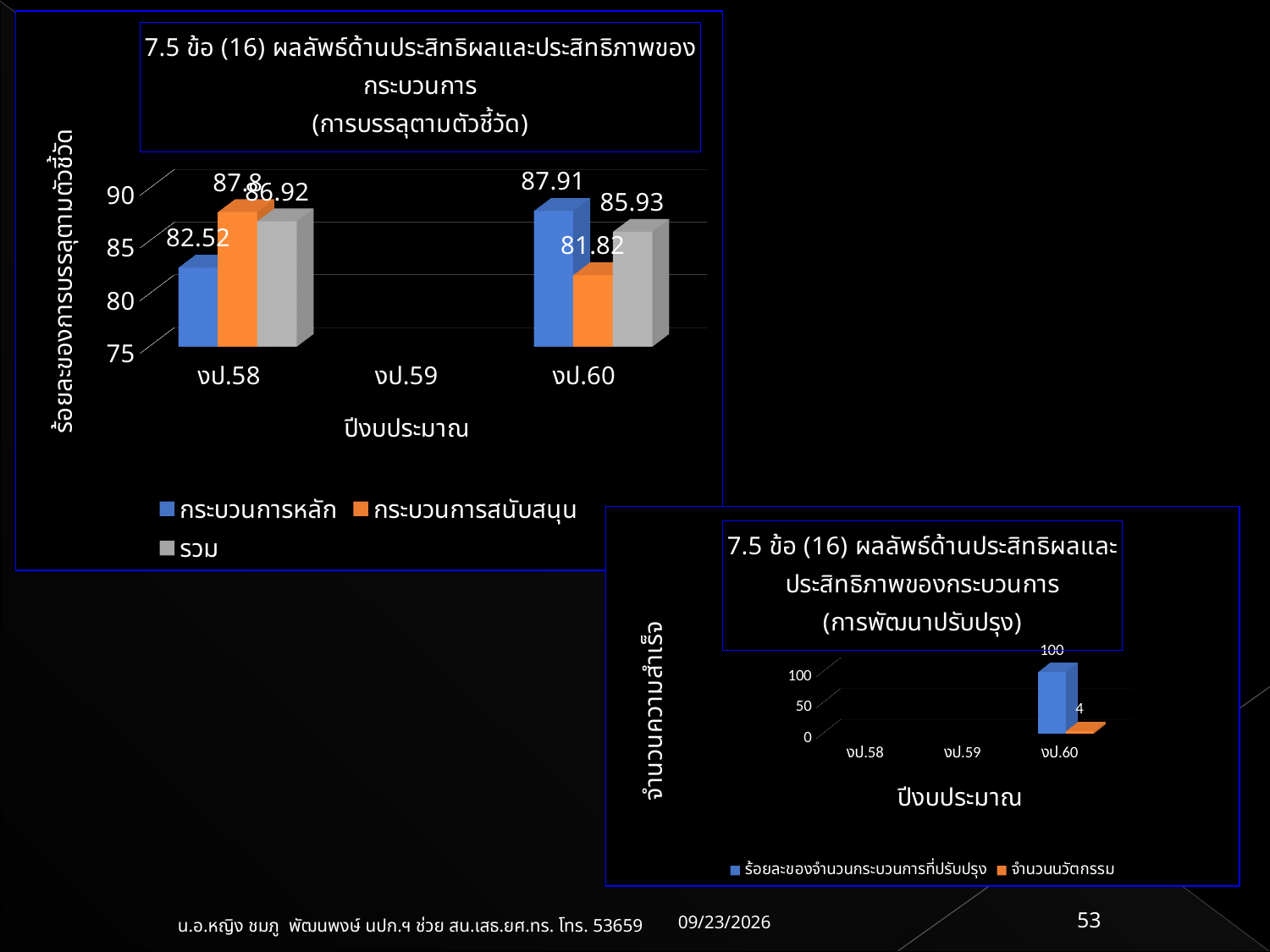
In the top-left chart (การบรรลุตามตัวชี้วัด), how many series does the legend list? 3 In the top-left chart (การบรรลุตามตัวชี้วัด), what is the difference between the รวม values for งป.58 and งป.60? 0.99 In the top-left chart (การบรรลุตามตัวชี้วัด), what is the value for รวม in งป.58? 86.92 In the top-left chart (การบรรลุตามตัวชี้วัด), how many fiscal-year categories are shown on the x axis? 3 In the top-left chart (การบรรลุตามตัวชี้วัด), what is the value for กระบวนการสนับสนุน in งป.60? 81.82 What kind of chart is the bottom-right chart (การพัฒนาปรับปรุง)? Bar chart In the top-left chart (การบรรลุตามตัวชี้วัด), is the value for กระบวนการสนับสนุน larger in งป.58 or งป.60? งป.58 In the top-left chart (การบรรลุตามตัวชี้วัด), which series has the highest value in งป.60? กระบวนการหลัก In the top-left chart (การบรรลุตามตัวชี้วัด), which series has the lowest value in งป.58? กระบวนการหลัก In the top-left chart (การบรรลุตามตัวชี้วัด), what is the value for กระบวนการหลัก in งป.58? 82.52 In the bottom-right chart (การพัฒนาปรับปรุง), what is the value for ร้อยละของจำนวนกระบวนการที่ปรับปรุง in งป.60? 100 In the bottom-right chart (การพัฒนาปรับปรุง), what is the value for จำนวนนวัตกรรม in งป.60? 4